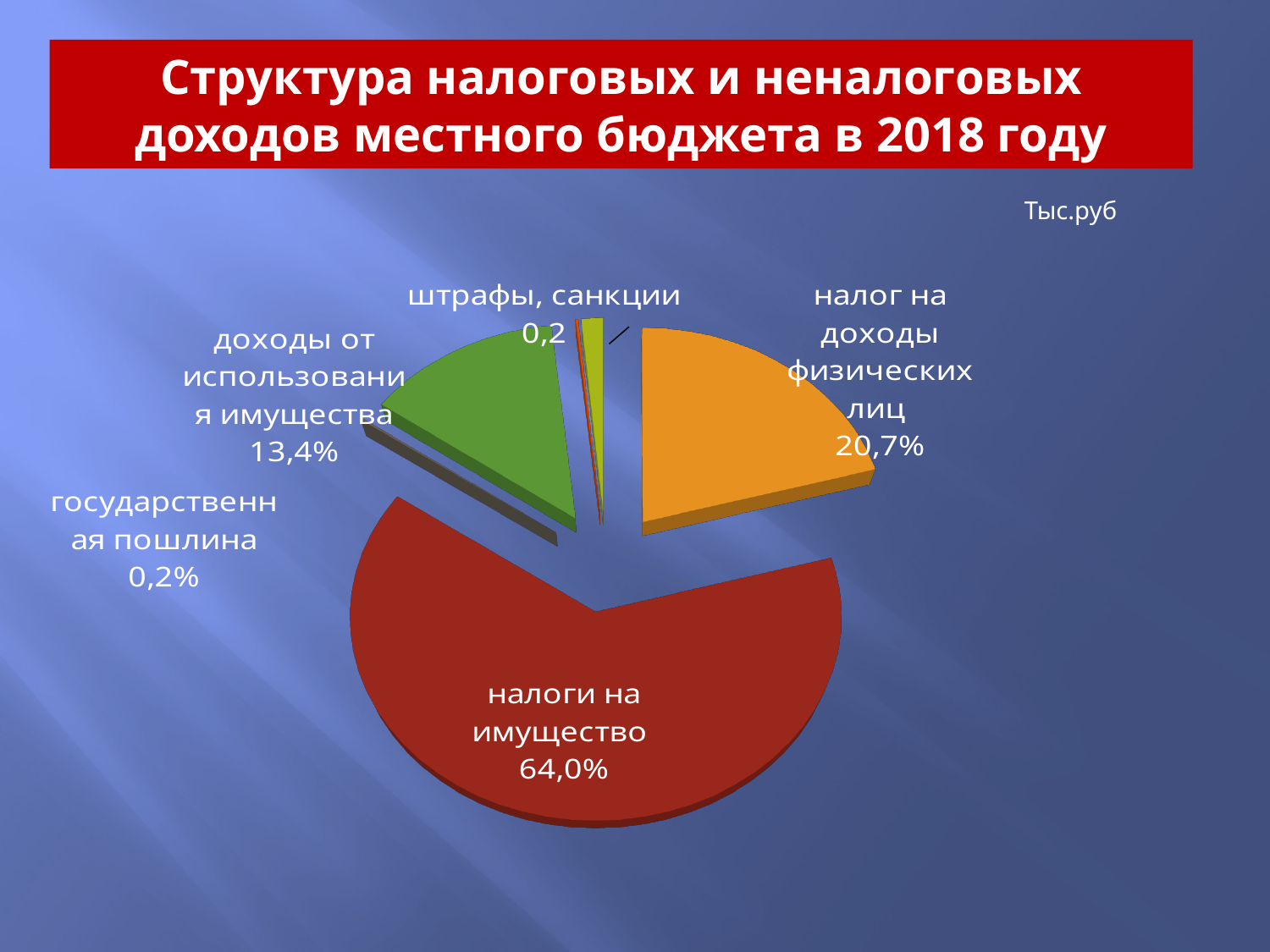
What colour is the slice for налоги на имущество? red Which category has the largest slice of the pie? налоги на имущество What share is shown for налог на доходы физических лиц? 20,7% By how many percentage points does налог на доходы физических лиц exceed доходы от использования имущества? 7,3% What kind of chart is shown on the slide? pie chart By how many percentage points does налоги на имущество exceed налог на доходы физических лиц? 43,3% What share is shown for доходы от использования имущества? 13,4% What share of the pie does налоги на имущество hold? 64,0% What share is shown for государственная пошлина? 0,2% Which is larger: налог на доходы физических лиц or доходы от использования имущества? налог на доходы физических лиц What is the title of the slide? Структура налоговых и неналоговых доходов местного бюджета в 2018 году